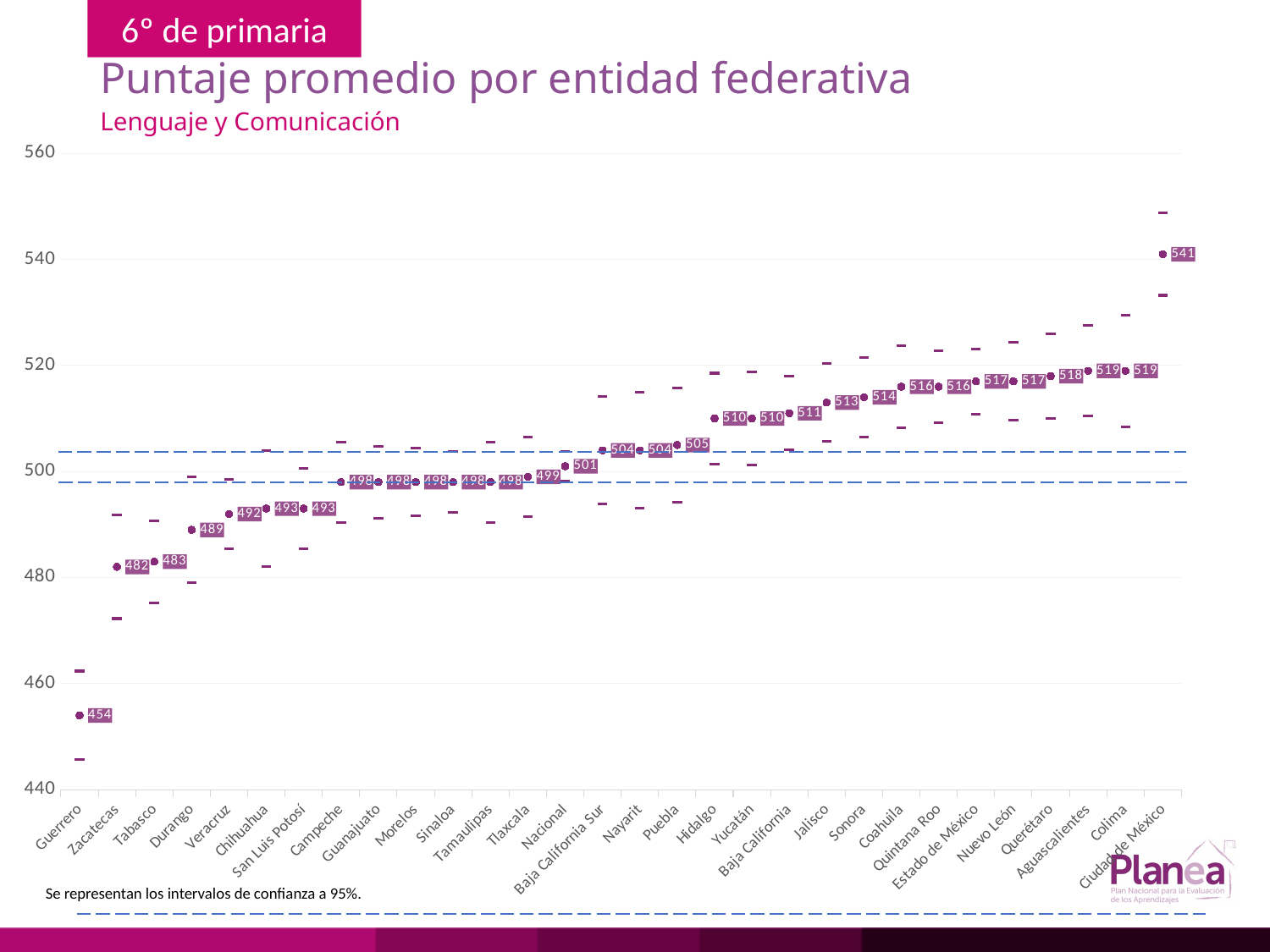
What is the average score shown for Ciudad de México? 541 Which entity has the lowest average score? Guerrero What is the difference between the scores of Ciudad de México and Guerrero? 87 Which has a higher score, Hidalgo or Durango? Hidalgo Which entity has the highest average score? Ciudad de México What subject is named in the chart's subtitle? Lenguaje y Comunicación Do the plotted values rise or fall from left to right along the x axis? rise How many entities (including Nacional) are plotted on the x axis? 30 What is the value plotted for Nacional? 501 What is the average score shown for Guerrero? 454 What is the average score shown for Jalisco? 513 According to the note at the bottom, what confidence level do the intervals represent? 95%